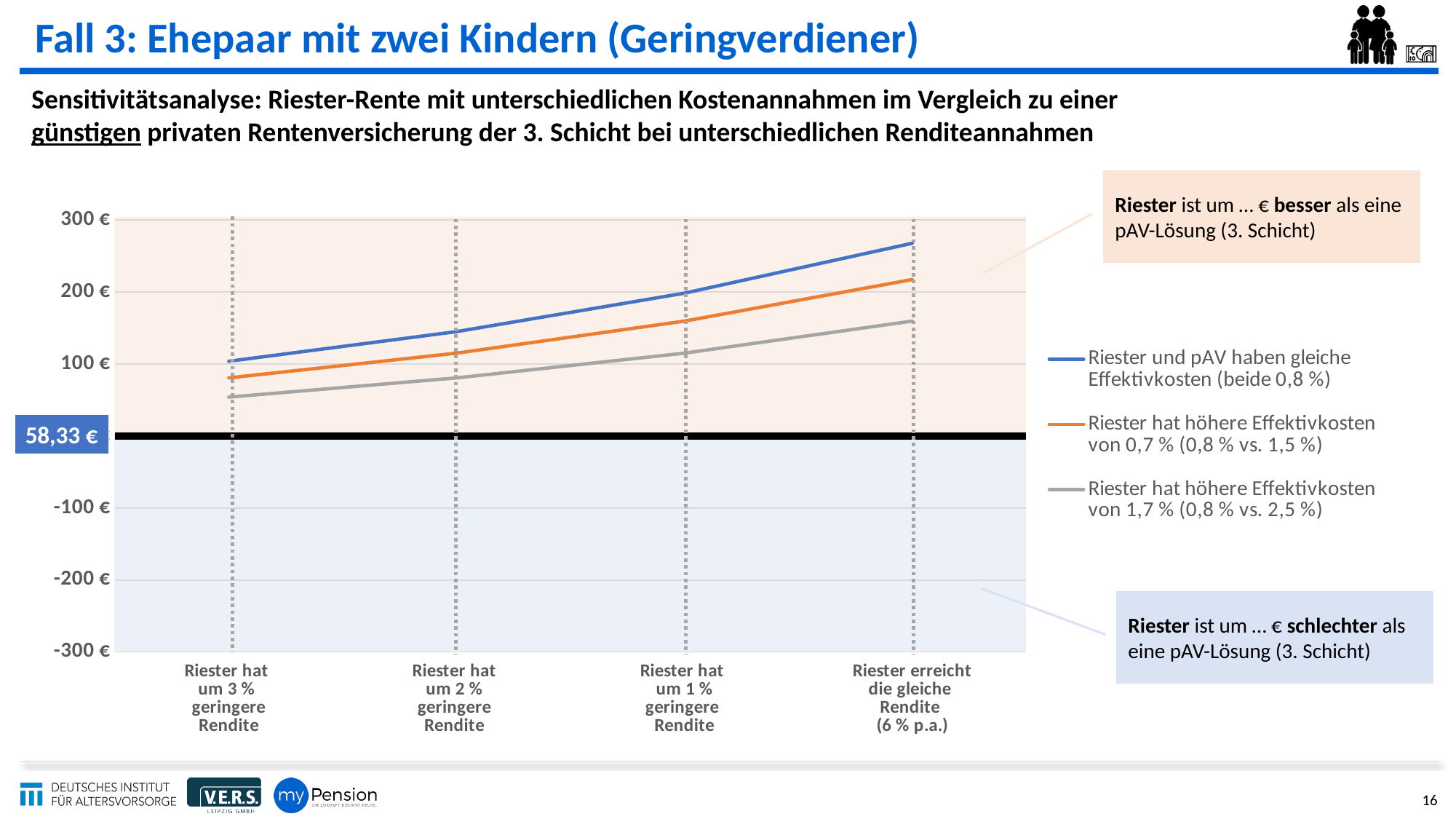
What kind of chart is shown on the slide? line chart At "Riester hat um 2 % geringere Rendite", which is larger: the value of "Riester und pAV haben gleiche Effektivkosten (beide 0,8 %)" or the value of "Riester hat höhere Effektivkosten von 1,7 % (0,8 % vs. 2,5 %)"? Riester und pAV haben gleiche Effektivkosten (beide 0,8 %) Is the value of the series "Riester und pAV haben gleiche Effektivkosten (beide 0,8 %)" at "Riester erreicht die gleiche Rendite (6 % p.a.)" greater or less than 200 €? greater What value is labelled on the thick black horizontal reference line in the chart? 58,33 € For the series "Riester hat höhere Effektivkosten von 1,7 % (0,8 % vs. 2,5 %)", which category has the lowest value? Riester hat um 3 % geringere Rendite Do the values of the series "Riester und pAV haben gleiche Effektivkosten (beide 0,8 %)" rise or fall from left to right along the x axis? rise How many series does the legend list? 3 Is the value of the series "Riester hat höhere Effektivkosten von 0,7 % (0,8 % vs. 1,5 %)" at "Riester hat um 1 % geringere Rendite" greater or less than 100 €? greater At "Riester erreicht die gleiche Rendite (6 % p.a.)", which series has the highest value? Riester und pAV haben gleiche Effektivkosten (beide 0,8 %) Is the value of the series "Riester hat höhere Effektivkosten von 1,7 % (0,8 % vs. 2,5 %)" at "Riester hat um 3 % geringere Rendite" greater or less than 100 €? less How many categories are shown along the x axis? 4